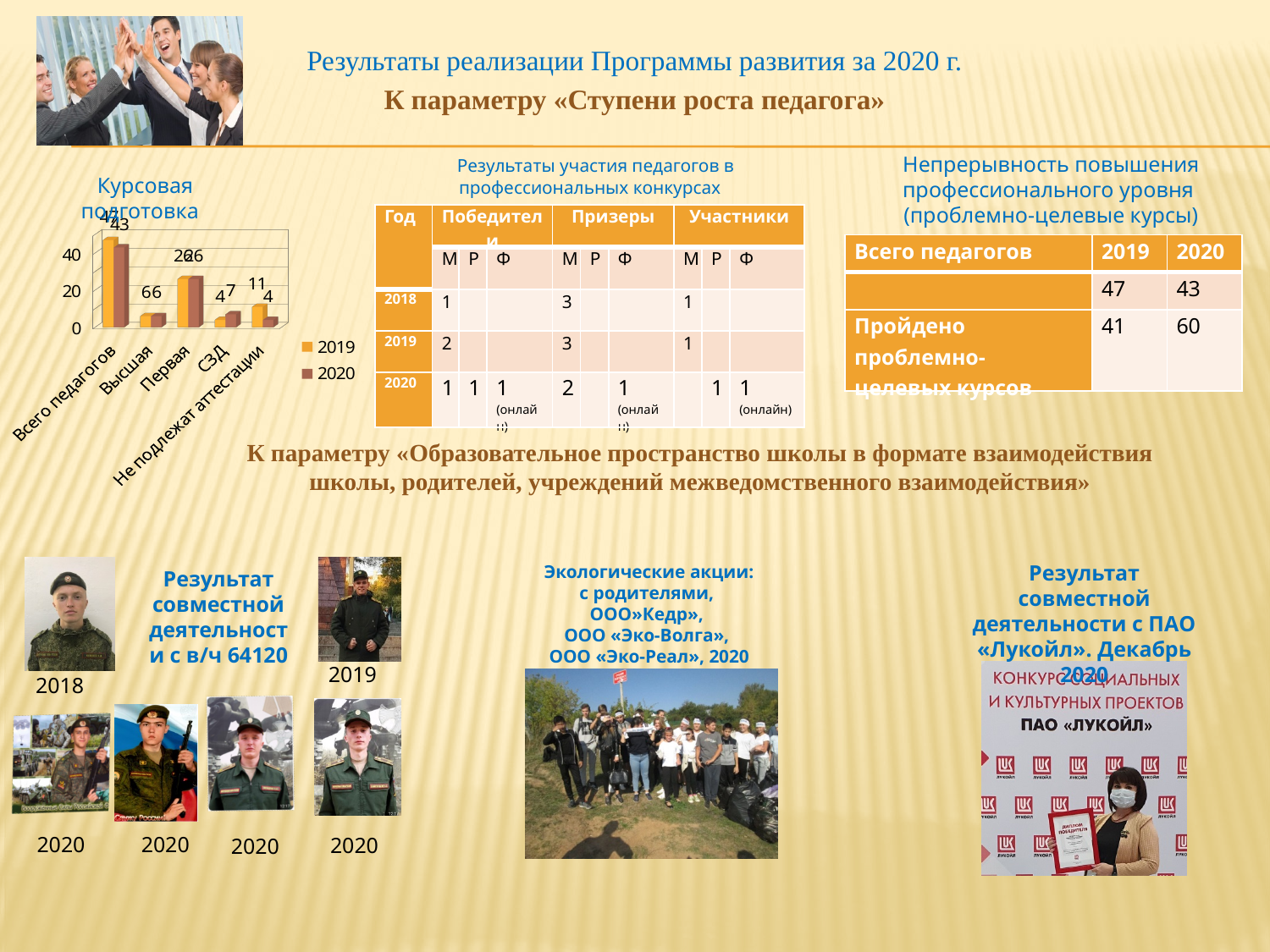
In the "Курсовая подготовка" chart, what is the 2020 value for "СЗД"? 7 How many series does the legend of the "Курсовая подготовка" chart list? 2 What are the legend entries of the "Курсовая подготовка" chart? 2019 and 2020 In the "Курсовая подготовка" chart, which year has the larger value for "Не подлежат аттестации", 2019 or 2020? 2019 In the "Курсовая подготовка" chart, what is the 2019 value for "Всего педагогов"? 47 In the "Курсовая подготовка" chart, what is the difference between the 2019 and 2020 values for "Всего педагогов"? 4 What kind of chart is the "Курсовая подготовка" chart? bar chart In the "Курсовая подготовка" chart, what is the 2019 value for "Не подлежат аттестации"? 11 In the "Курсовая подготовка" chart, what is the 2020 value for "Первая"? 26 In the "Курсовая подготовка" chart, which category has the highest 2019 value? Всего педагогов In the "Курсовая подготовка" chart, what is the 2020 value for "Всего педагогов"? 43 How many categories are shown on the x axis of the "Курсовая подготовка" chart? 5